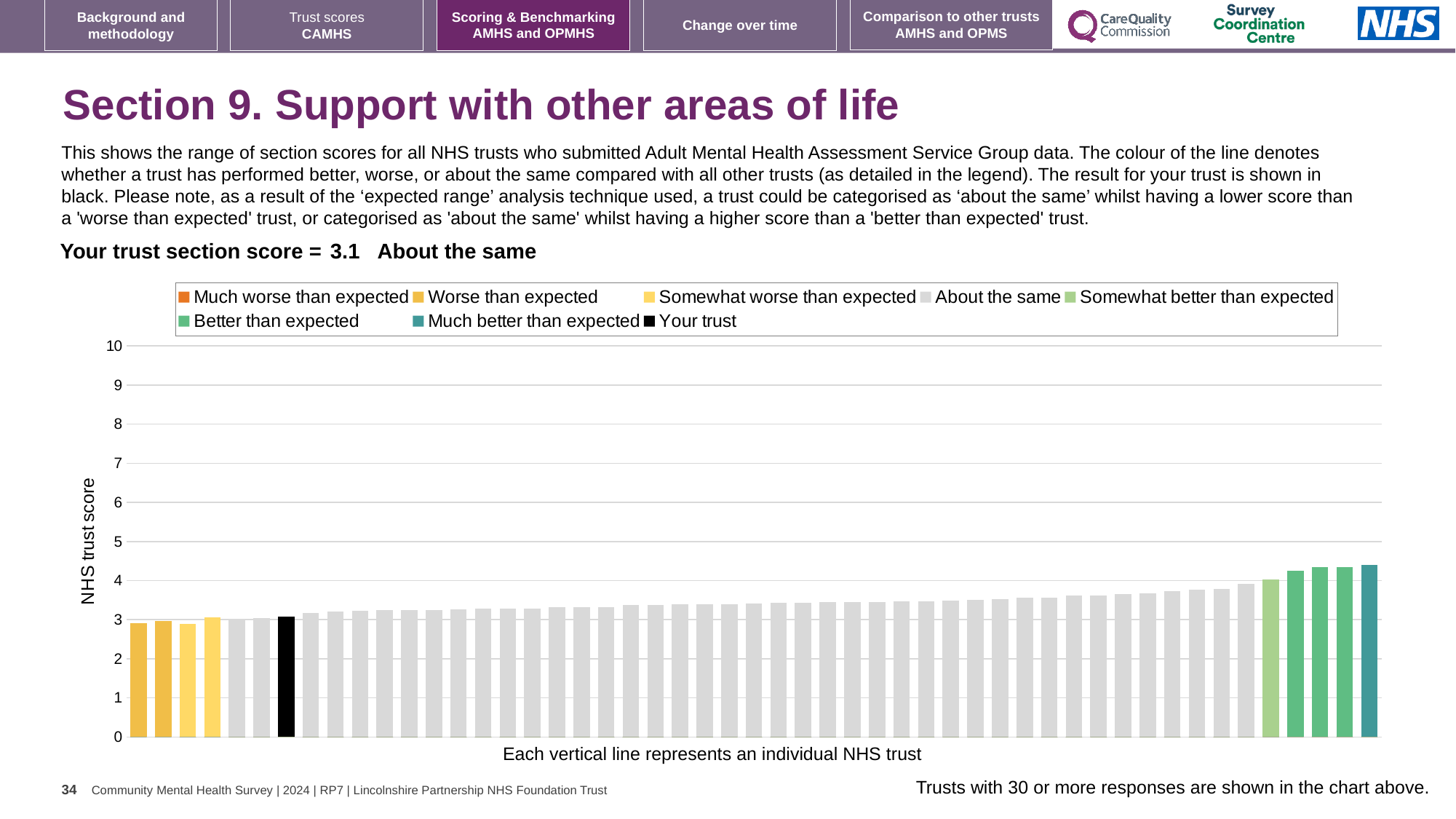
Which performance category is your trust's section score placed in? About the same Do the bar values rise or fall from left to right along the x axis? rise What is the section score for your trust shown on the slide? 3.1 Is the tallest bar in the chart greater or less than 4? greater Is the tallest bar in the chart greater or less than 5? less Is the value for your trust greater or less than 3? greater What is the highest tick value shown on the y axis? 10 Which legend category does the tallest bar on the right of the chart belong to? Much better than expected What kind of chart is shown on the slide? bar chart What colour is the bar representing your trust? black How many entries does the chart legend list? 8